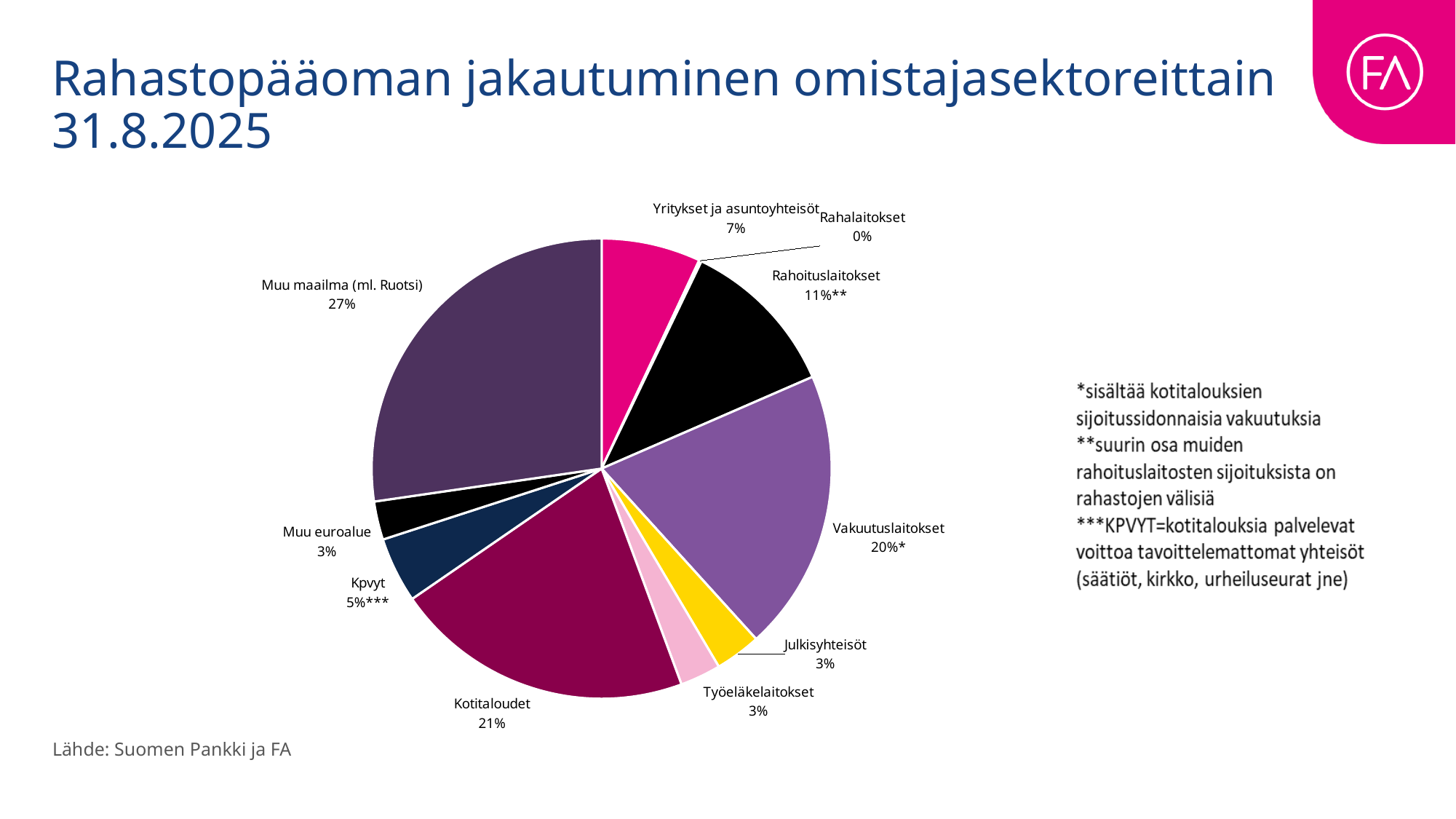
How many categories are shown in the pie chart? 10 Which is larger, the share of Kotitaloudet or the share of Vakuutuslaitokset? Kotitaloudet What is the difference between the shares of Muu maailma (ml. Ruotsi) and Kotitaloudet? 6 percentage points What is the value shown for Vakuutuslaitokset? 20% What is the value shown for Kpvyt? 5% Which category has the largest slice of the pie? Muu maailma (ml. Ruotsi) Which category has the smallest slice of the pie? Rahalaitokset What share of the pie does Muu maailma (ml. Ruotsi) hold? 27% What is the title of the slide containing the chart? Rahastopääoman jakautuminen omistajasektoreittain 31.8.2025 What type of chart is shown on the slide? pie chart What is the value shown for Kotitaloudet? 21% What is the value shown for Yritykset ja asuntoyhteisöt? 7%